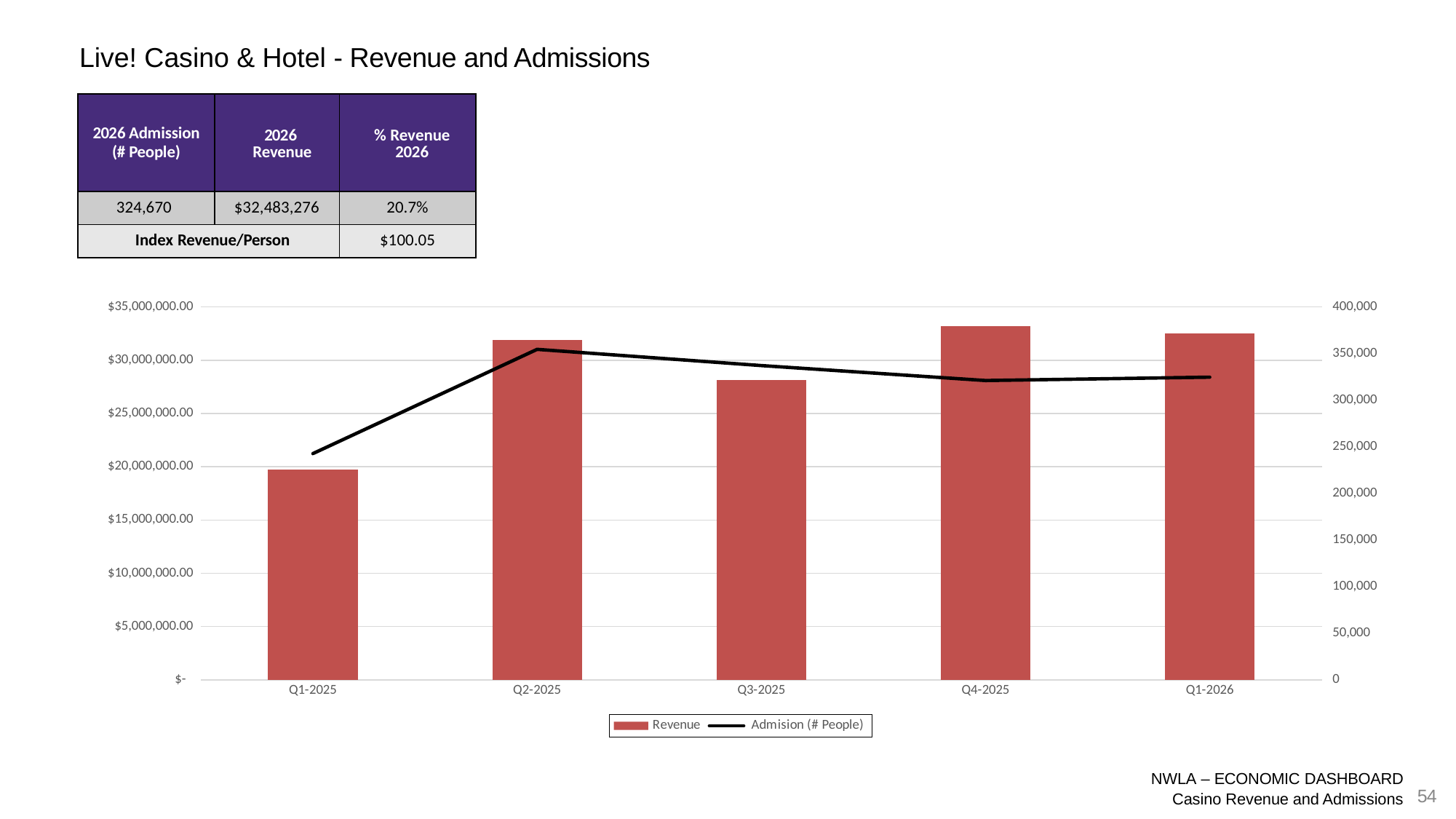
Is the Admission (# People) value for Q2-2025 greater or less than 300,000? greater How many quarters are shown on the x axis of the chart? 5 Does Revenue rise or fall from Q2-2025 to Q3-2025? Fall What are the two entries in the chart legend? Revenue and Admision (# People) How many series does the chart legend list? 2 Is the Revenue for Q1-2025 greater or less than $15,000,000.00? greater Which quarter has the lowest Revenue bar? Q1-2025 What kind of chart is used to show Revenue on the slide? Bar chart Which quarter has the lowest Admission (# People) value on the line? Q1-2025 Which quarter has the larger Revenue, Q2-2025 or Q3-2025? Q2-2025 Is the Revenue for Q3-2025 greater or less than $25,000,000.00? greater Which quarter has the highest Admission (# People) value on the line? Q2-2025